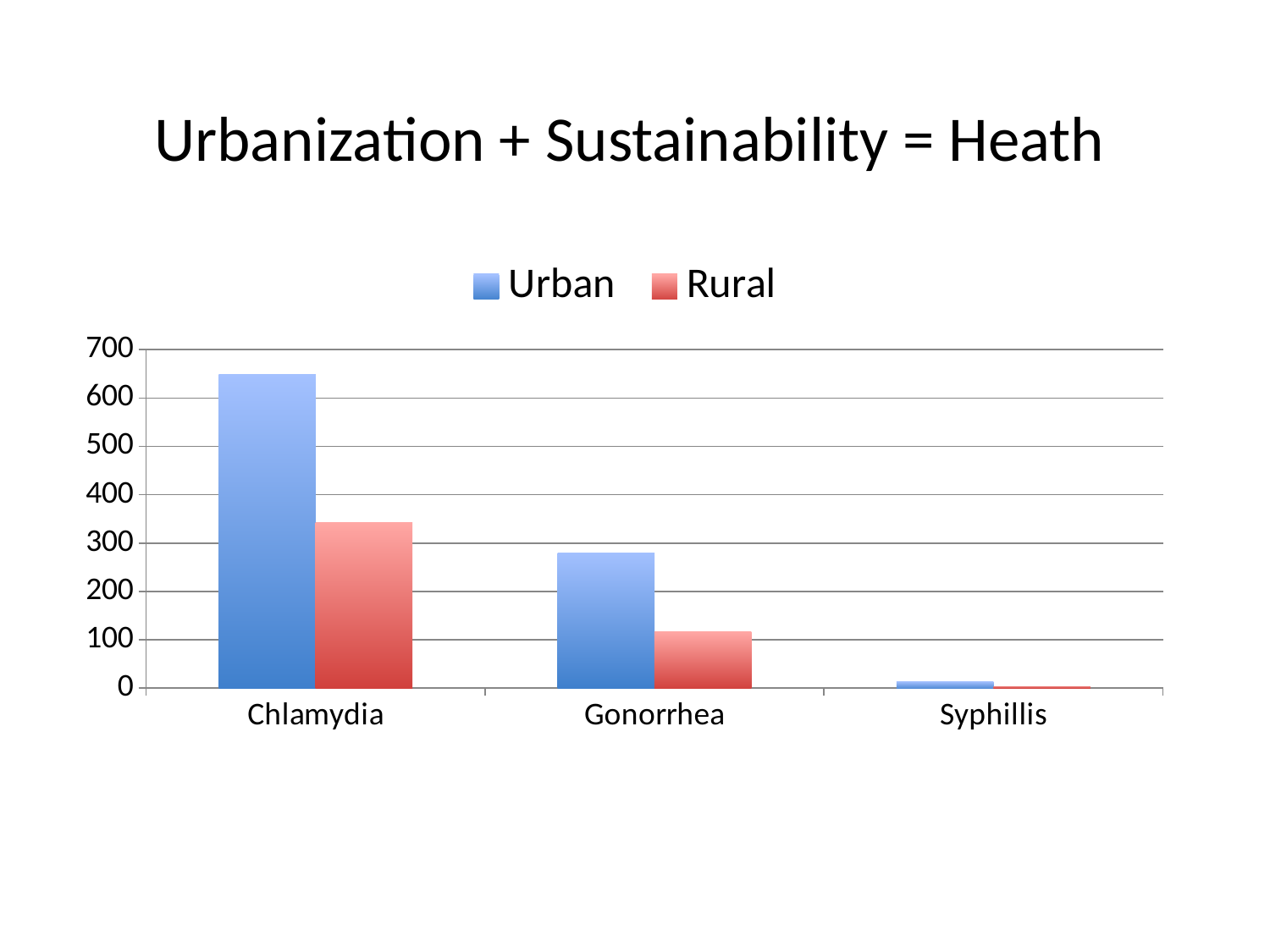
Is the Urban value for Chlamydia greater or less than 600? greater Do the Urban values rise or fall from Chlamydia to Syphillis along the x axis? fall How many categories are shown on the x axis? 3 Which is larger for Gonorrhea, the Urban value or the Rural value? Urban What is the title of the slide? Urbanization + Sustainability = Heath What kind of chart is shown on the slide? bar chart How many series does the legend list? 2 Which category has the highest Urban value? Chlamydia Is the Rural value for Chlamydia greater or less than 300? greater Is the Rural value for Gonorrhea greater or less than 200? less Which category has the lowest Rural value? Syphillis What are the two series named in the legend? Urban and Rural